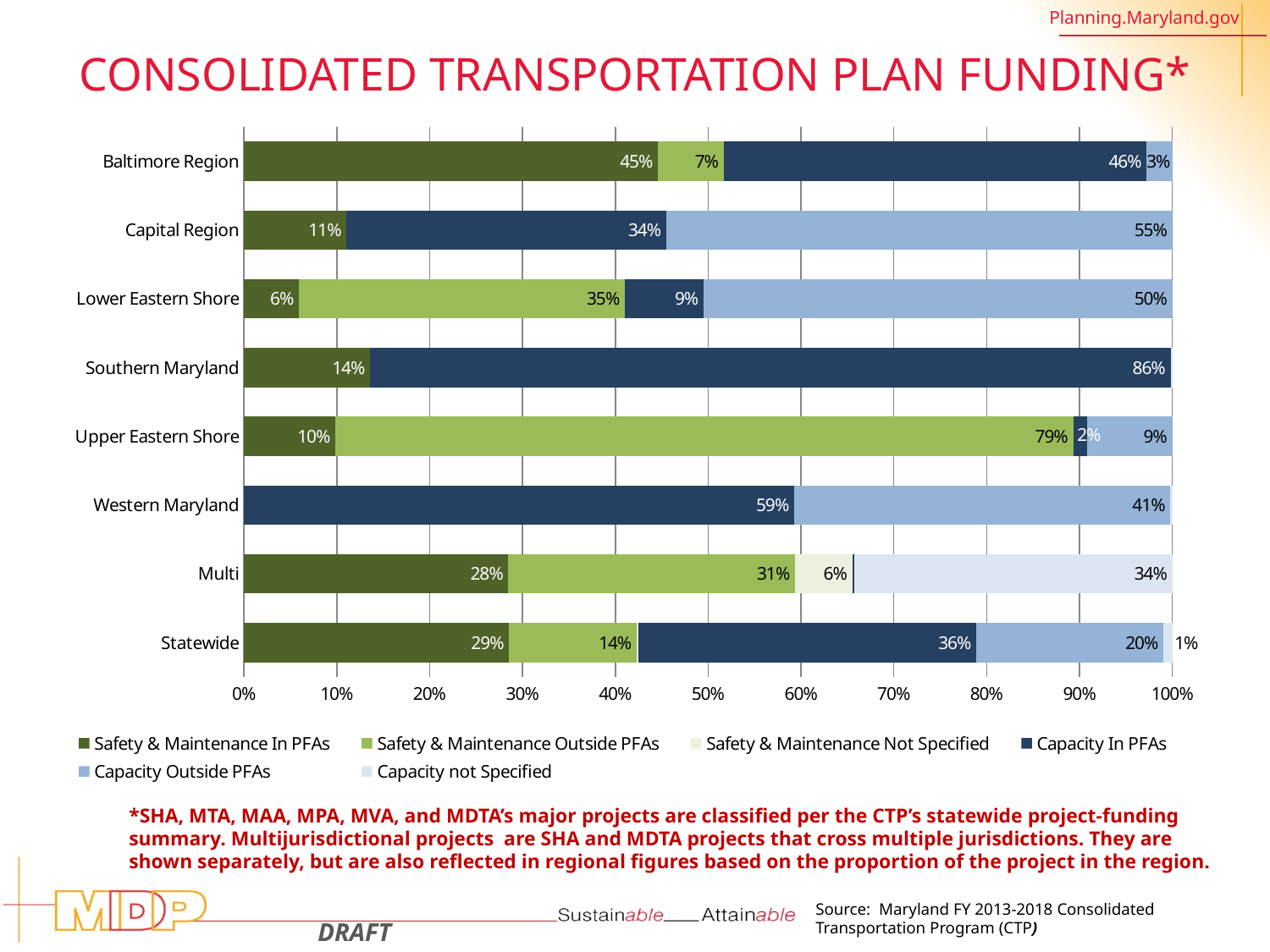
What is the title of the chart? CONSOLIDATED TRANSPORTATION PLAN FUNDING* What kind of chart is shown on the slide? Stacked bar chart What is the Safety & Maintenance Not Specified share for Multi? 6% What is the Safety & Maintenance Outside PFAs share for the Upper Eastern Shore? 79% What is the Capacity In PFAs share for Southern Maryland? 86% How many regions or categories are plotted on the chart? 8 Which region has the lowest Safety & Maintenance In PFAs share among those with a labelled value? Lower Eastern Shore Which is larger for Statewide: the Capacity In PFAs share or the Safety & Maintenance In PFAs share? Capacity In PFAs What is the difference between the Capacity In PFAs share for Western Maryland and its Capacity Outside PFAs share? 18% Which region has the highest Safety & Maintenance In PFAs share? Baltimore Region How many series does the legend list? 6 What is the Capacity Outside PFAs share for the Capital Region? 55%